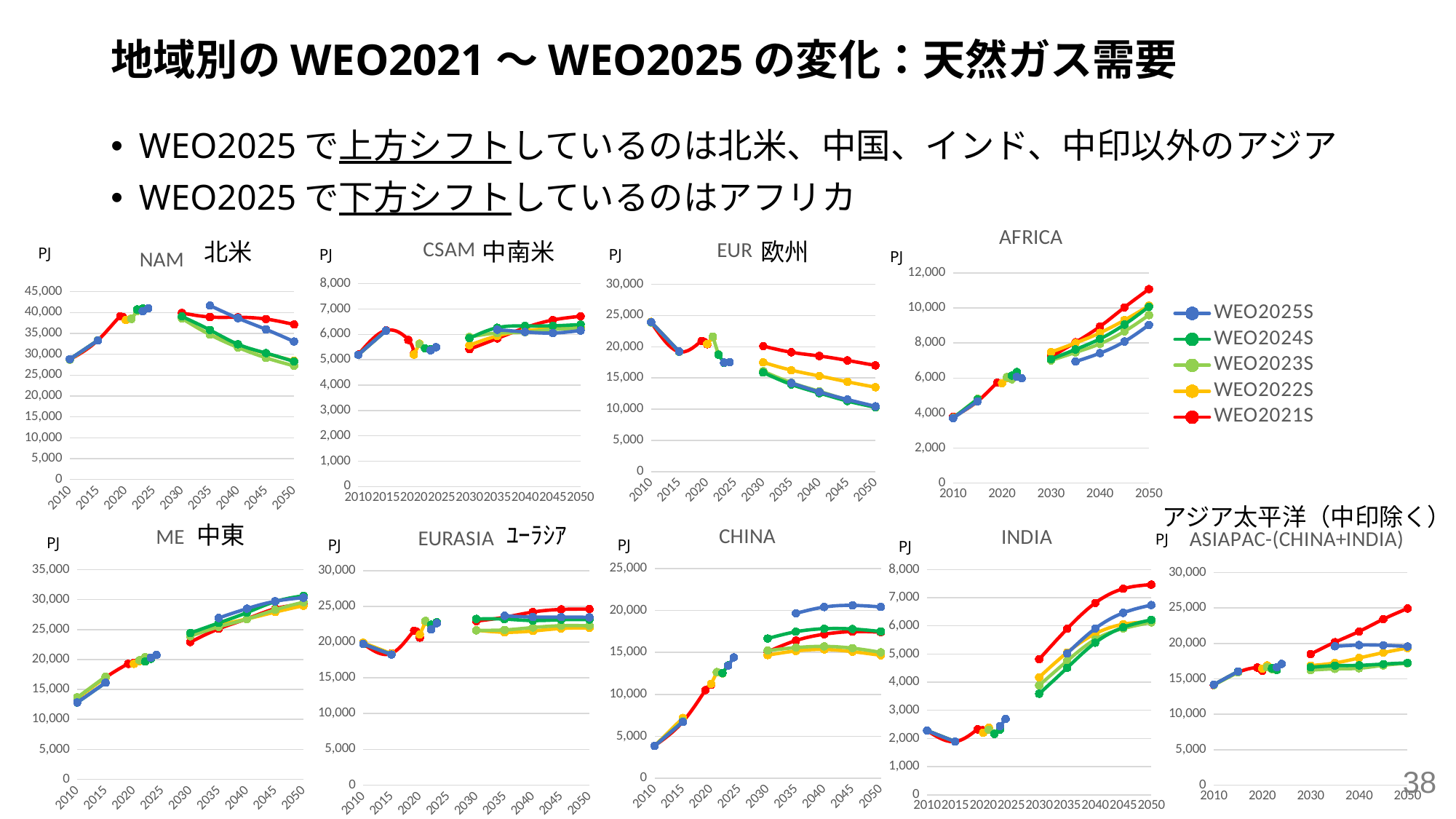
In the AFRICA chart, which series has the highest value in 2050? WEO2021S In the EUR (欧州) chart, which series has the highest value in 2050? WEO2021S In the EUR (欧州) chart, is the value for WEO2025S in 2050 greater or less than 15,000? less In the CHINA chart, which series has the larger value in 2050, WEO2025S or WEO2021S? WEO2025S How many series does the legend list? 5 In the ASIAPAC-(CHINA+INDIA) chart, is the value for WEO2021S in 2050 greater or less than 20,000? greater In the EUR (欧州) chart, does the WEO2025S line rise or fall from 2030 to 2050? fall What kind of chart is the NAM (北米) chart? line chart In the AFRICA chart, is the value for WEO2021S in 2050 greater or less than 10,000? greater In the INDIA chart, which series has the larger value in 2050, WEO2021S or WEO2025S? WEO2021S What are the series names listed in the legend? WEO2025S, WEO2024S, WEO2023S, WEO2022S, WEO2021S In the ME (中東) chart, does the WEO2025S line rise or fall from 2030 to 2050? rise